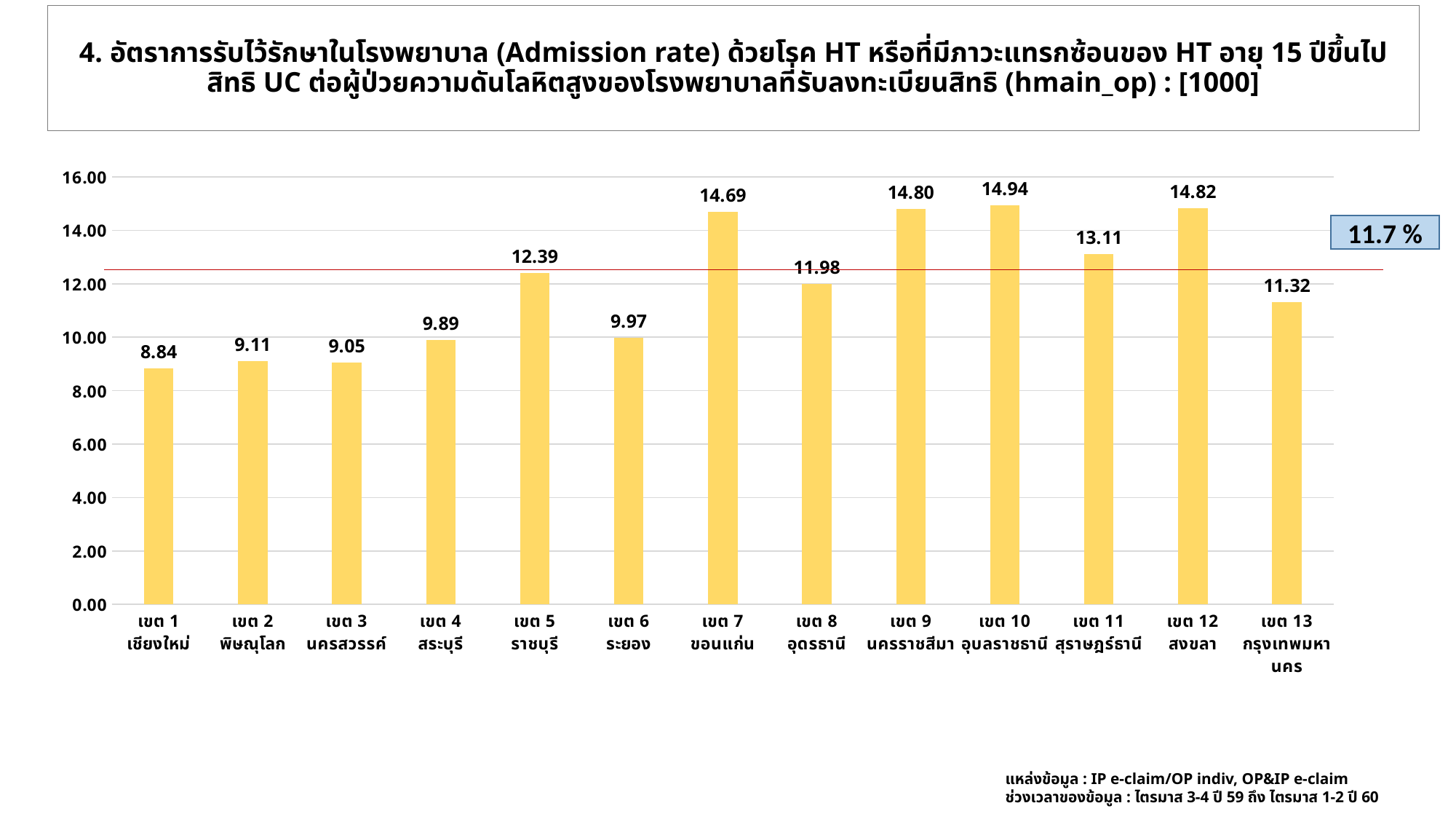
Is the value for เขต 9 นครราชสีมา greater or less than 14.00? greater What kind of chart is shown on the slide? bar chart Which region has the highest value? เขต 10 อุบลราชธานี How many regions (เขต) are shown on the x axis? 13 What is the difference between the values for เขต 11 สุราษฎร์ธานี and เขต 8 อุดรธานี? 1.13 What is the value for เขต 13 กรุงเทพมหานคร? 11.32 What is the value for เขต 7 ขอนแก่น? 14.69 What is the value for เขต 4 สระบุรี? 9.89 What is the difference between the values for เขต 10 อุบลราชธานี and เขต 1 เชียงใหม่? 6.10 Which region has the lowest value? เขต 1 เชียงใหม่ Which has a larger value, เขต 5 ราชบุรี or เขต 6 ระยอง? เขต 5 ราชบุรี What percentage is shown in the blue box next to the red reference line? 11.7 %